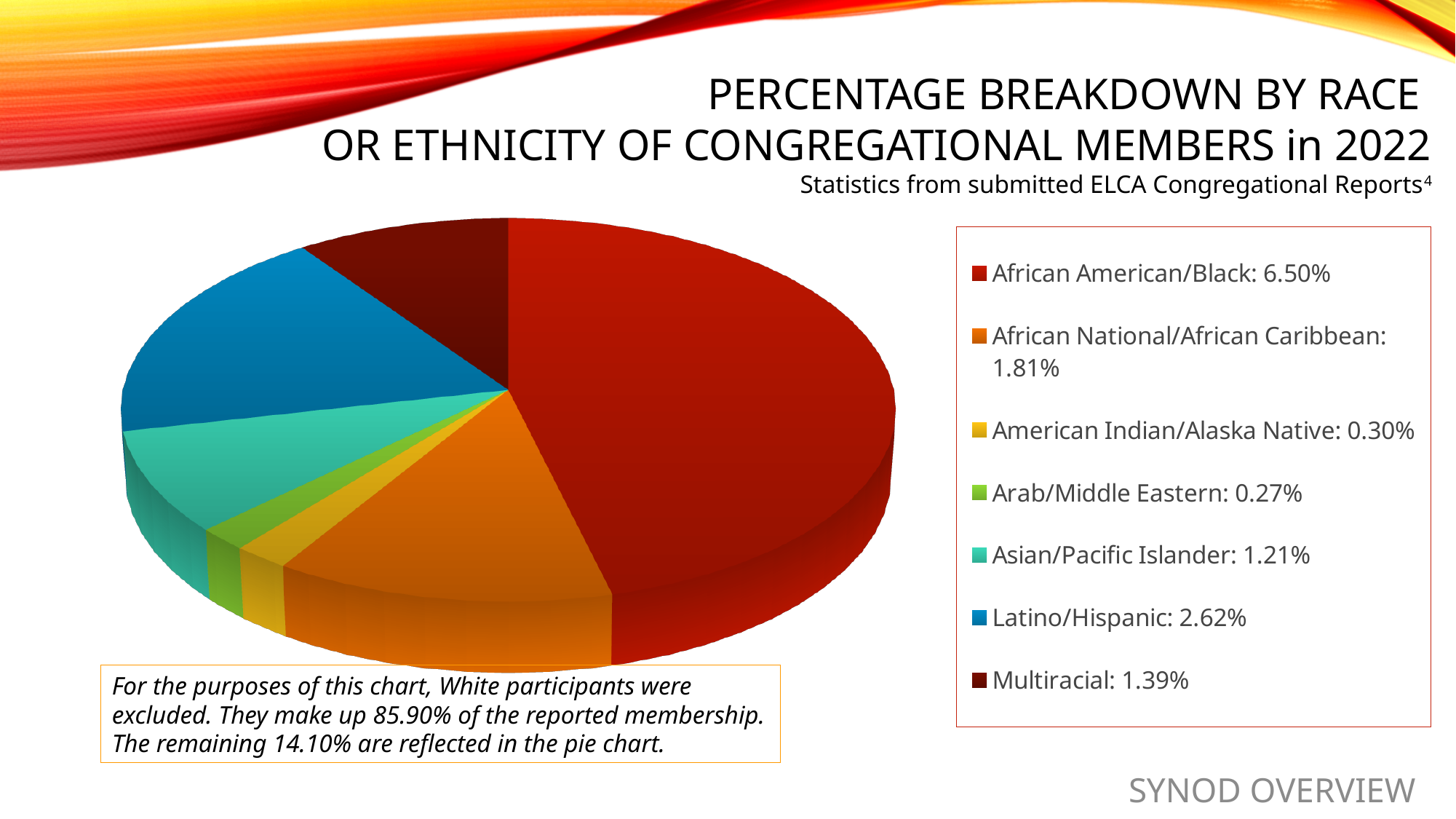
What kind of chart is shown on the slide? pie chart What percentage is shown for Latino/Hispanic? 2.62% What percentage is shown for Asian/Pacific Islander? 1.21% What percentage is shown for African American/Black? 6.50% Which category has the largest share in the pie chart? African American/Black What percentage is shown for American Indian/Alaska Native? 0.30% How many categories does the pie chart show? 7 Which is larger, the percentage for Latino/Hispanic or for African National/African Caribbean? Latino/Hispanic What colour is the Latino/Hispanic slice in the pie chart? blue What is the difference between the African American/Black and Latino/Hispanic percentages? 3.88% What is the difference between the Multiracial and Asian/Pacific Islander percentages? 0.18% Which category has the smallest percentage in the legend? Arab/Middle Eastern